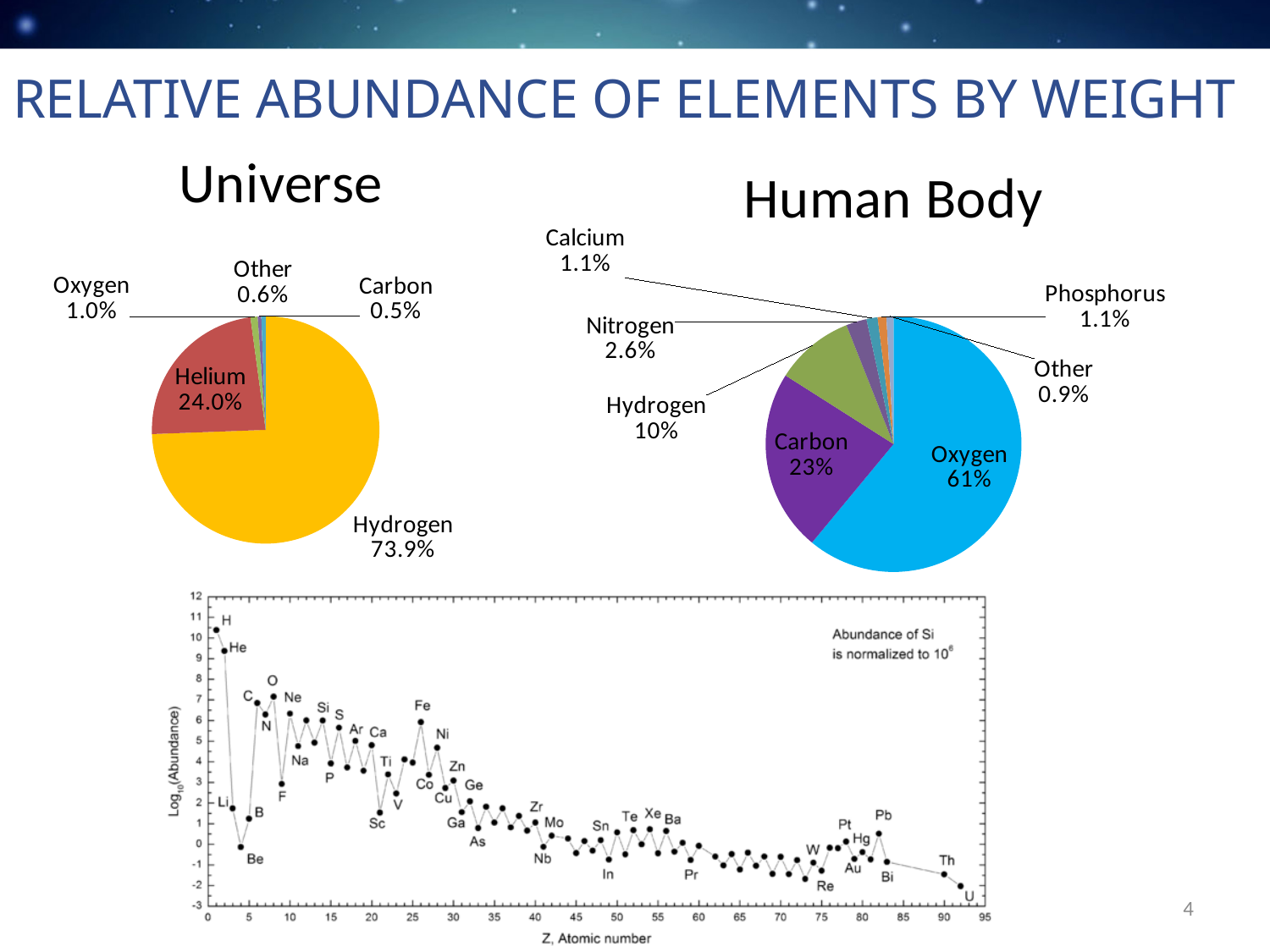
In the Human Body pie chart, how many slices are there? 7 In the Human Body pie chart, what percentage is Nitrogen? 2.6% What kind of chart is the bottom chart with Z, Atomic number on the x axis? line chart In the Universe pie chart, how many slices are there? 5 Which is larger: the Hydrogen share in the Universe pie chart or the Hydrogen share in the Human Body pie chart? Universe In the bottom chart, is the Log10(Abundance) value for H greater or less than 10? greater In the Universe pie chart, what percentage is Helium? 24.0% In the Human Body pie chart, which element has the largest share? Oxygen In the Human Body pie chart, what is the difference between the Oxygen and Carbon shares? 38% In the Human Body pie chart, what percentage is Carbon? 23% In the Universe pie chart, which element has the smallest share? Carbon In the Universe pie chart, what percentage is Hydrogen? 73.9%